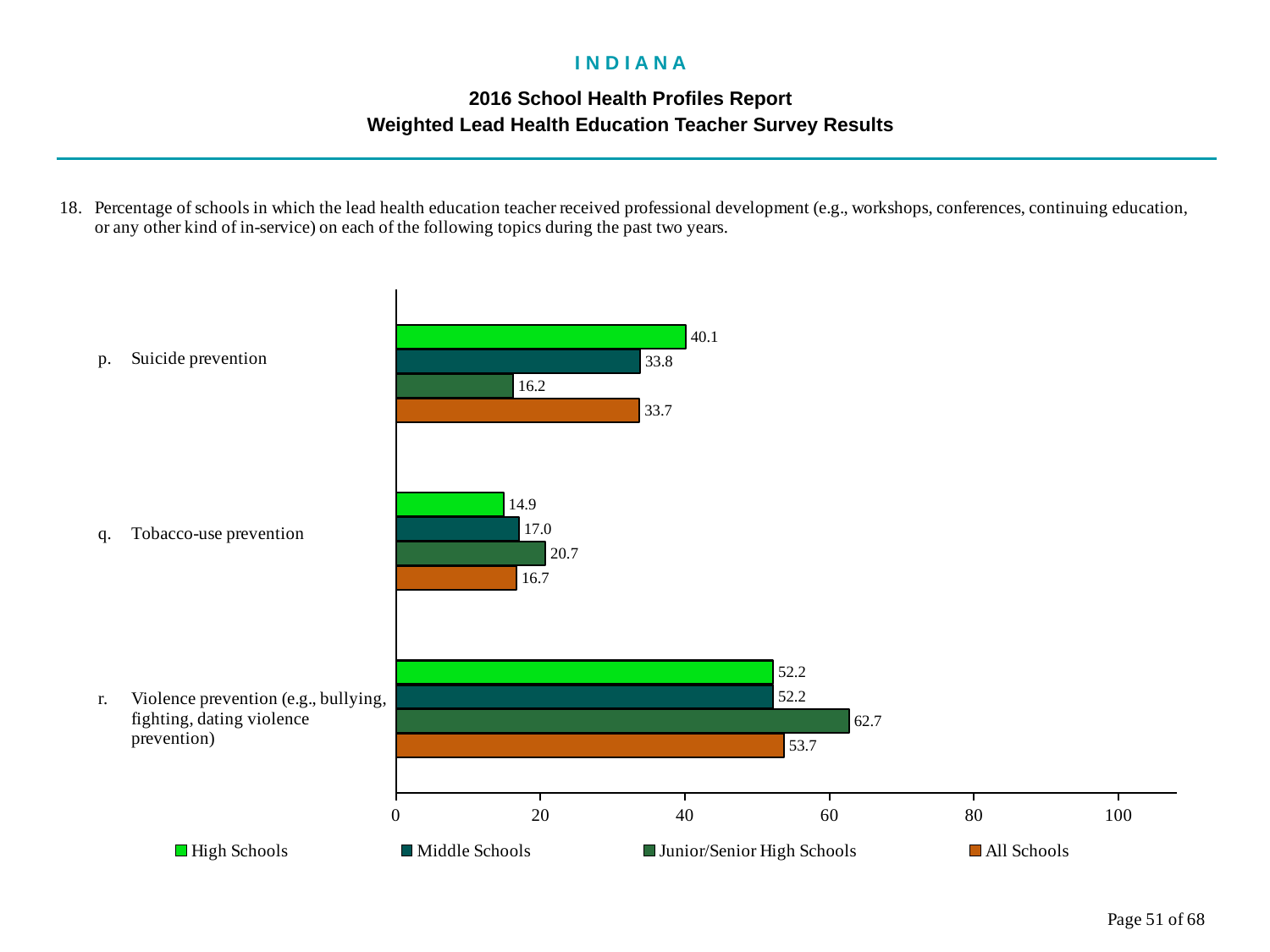
Is the value for Junior/Senior High Schools for Violence prevention greater or less than 60? greater What is the value for Junior/Senior High Schools for Tobacco-use prevention? 20.7 Which school type has the highest value for Violence prevention? Junior/Senior High Schools Which school type has the lowest value for Suicide prevention? Junior/Senior High Schools What is the value for High Schools for Suicide prevention? 40.1 What is the difference between the High Schools and Junior/Senior High Schools values for Suicide prevention? 23.9 Which legend entry is shown in orange? All Schools Which is larger for Tobacco-use prevention: the Middle Schools value or the Junior/Senior High Schools value? Junior/Senior High Schools How many series does the legend list? 4 How many topics (categories) are shown on the chart? 3 What kind of chart is shown on the slide? bar chart What is the value for All Schools for Violence prevention? 53.7